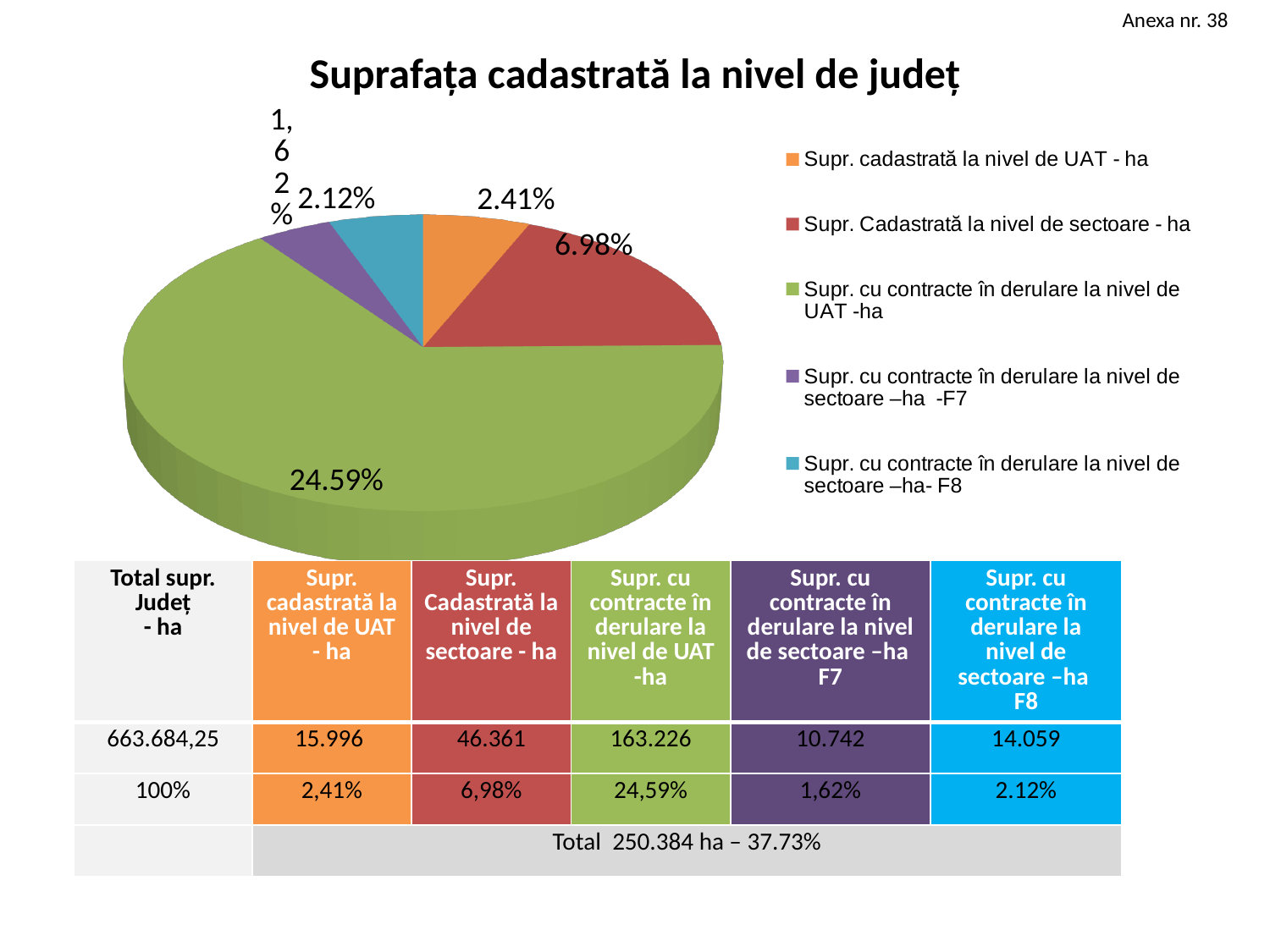
What is the difference in percentage points between 'Supr. cu contracte în derulare la nivel de UAT -ha' and 'Supr. Cadastrată la nivel de sectoare - ha'? 17.61% What type of chart is shown on the slide? pie chart How many slices does the pie chart have? 5 What percentage is shown for 'Supr. cu contracte în derulare la nivel de UAT -ha'? 24.59% What is the title of the chart? Suprafața cadastrată la nivel de județ What percentage is shown for 'Supr. Cadastrată la nivel de sectoare - ha'? 6.98% How many entries does the chart legend list? 5 What percentage is shown for 'Supr. cu contracte în derulare la nivel de sectoare –ha- F8'? 2.12% Which category has the largest slice of the pie? Supr. cu contracte în derulare la nivel de UAT -ha What percentage is shown for 'Supr. cadastrată la nivel de UAT - ha'? 2.41% Which category has the smallest slice of the pie? Supr. cu contracte în derulare la nivel de sectoare –ha -F7 Which is larger: the slice for 'Supr. cadastrată la nivel de UAT - ha' or the slice for 'Supr. cu contracte în derulare la nivel de sectoare –ha- F8'? Supr. cadastrată la nivel de UAT - ha